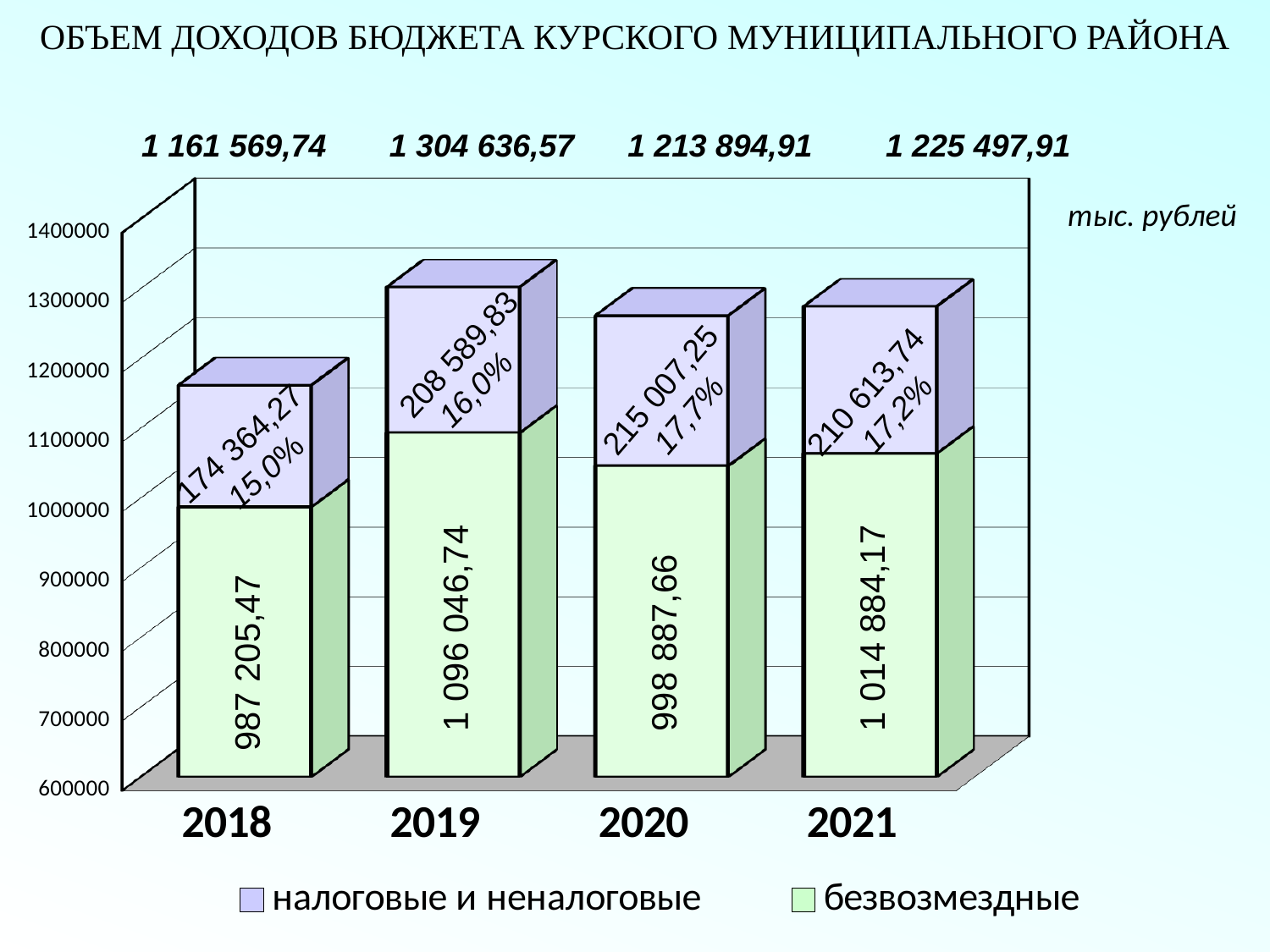
What is the difference between the total for 2019 and the total for 2018? 143 066,83 What is the value of безвозмездные for 2019? 1 096 046,74 What is the total of the stacked bar for 2021? 1 225 497,91 How many years are shown on the x axis? 4 Which year has the lowest value for налоговые и неналоговые? 2018 Which year has the highest total budget income? 2019 Which is larger, the безвозмездные value for 2020 or for 2021? 2021 What percentage is shown for налоговые и неналоговые in 2018? 15,0% What is the difference between the налоговые и неналоговые values for 2020 and 2021? 4 393,51 What is the value of налоговые и неналоговые for 2020? 215 007,25 How many series does the legend list? 2 What kind of chart is shown on the slide? Stacked bar chart